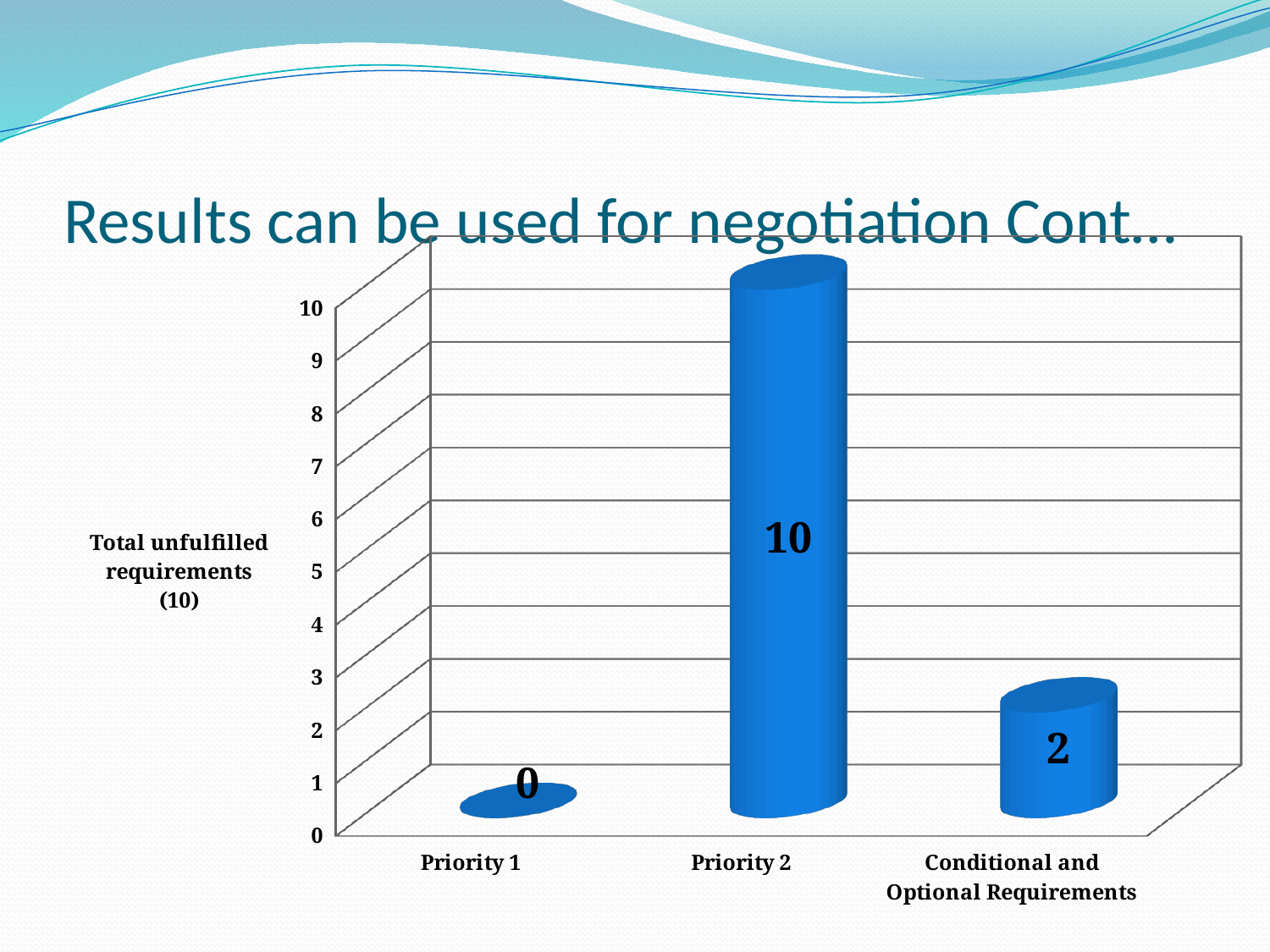
Is the value for Priority 2 greater or less than 5? greater What is the value for Conditional and Optional Requirements? 2 What is the label on the vertical axis of the chart? Total unfulfilled requirements (10) How many categories are shown on the x axis? 3 What kind of chart is shown on the slide? bar chart What is the maximum value shown on the vertical axis? 10 What is the difference between the values for Priority 2 and Conditional and Optional Requirements? 8 Which category has the highest value? Priority 2 What is the value for Priority 1? 0 Which category has the lowest value? Priority 1 What is the value for Priority 2? 10 Which is larger, the value for Priority 2 or the value for Conditional and Optional Requirements? Priority 2